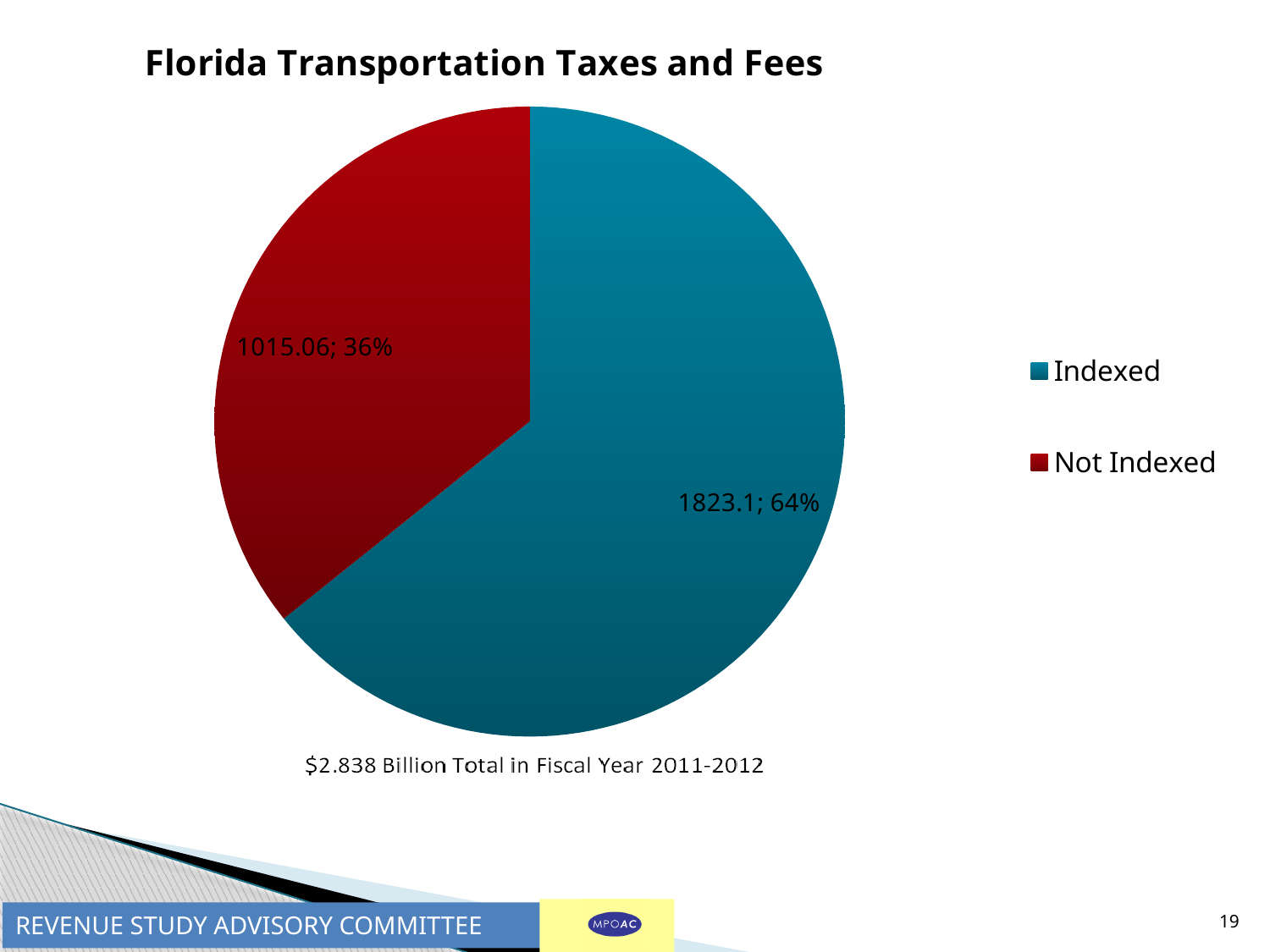
Which slice is the largest? Indexed What kind of chart is shown on the slide? pie chart What is the title of the chart? Florida Transportation Taxes and Fees What colour is the Not Indexed slice? dark red What is the value for Indexed? 1823.1 What share of the pie is Indexed? 64% What is the difference between the Indexed and Not Indexed values? 808.04 Which slice is the smallest? Not Indexed Which is larger, Indexed or Not Indexed? Indexed What share of the pie is Not Indexed? 36% How many slices does the pie chart have? 2 What is the value for Not Indexed? 1015.06